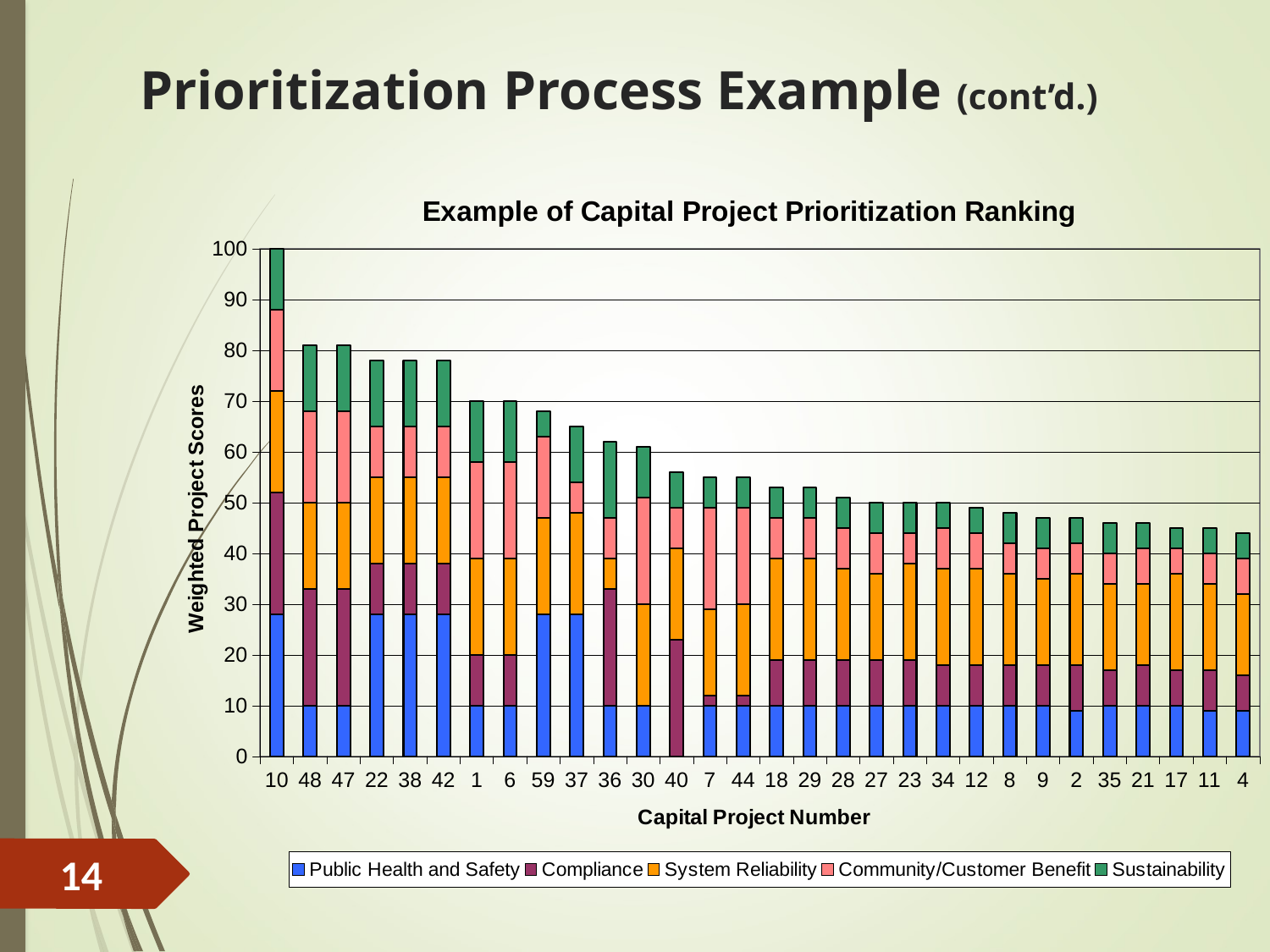
Is the total weighted project score for capital project 22 greater or less than 70? greater What is the total weighted project score for capital project 10? 100 Is the total weighted project score for capital project 40 greater or less than 60? less How many capital projects are plotted along the x axis? 30 Which has the larger total weighted project score, capital project 22 or capital project 36? 22 What kind of chart is shown on the slide? Stacked bar chart What is the label of the x axis? Capital Project Number What is the title of the chart? Example of Capital Project Prioritization Ranking How many series does the legend list? 5 Do the total weighted project scores rise or fall from left to right along the x axis? Fall Is the total weighted project score for capital project 4 greater or less than 50? less Which capital project number has the highest total weighted project score? 10